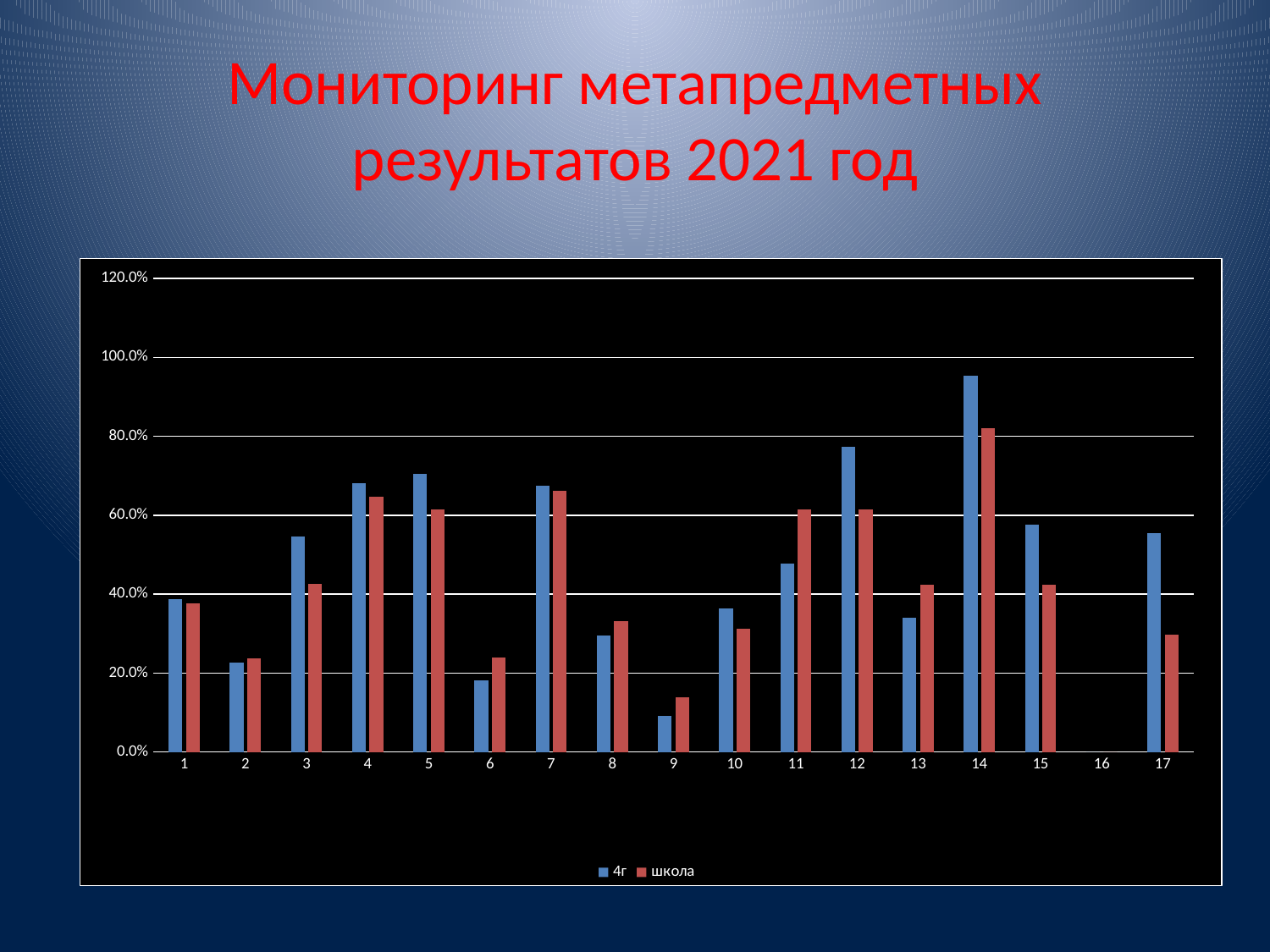
For category 11, which series has the larger value, 4г or школа? школа Is the 4г value for category 14 greater or less than 80.0%? greater For category 15, which series has the larger value, 4г or школа? 4г What kind of chart is shown on the slide? bar chart Which category has the highest value for the школа series? 14 How many categories are labelled on the x axis? 17 How many series does the legend list? 2 Is the 4г value for category 9 greater or less than 20.0%? less Among the categories with bars, which has the lowest value for the 4г series? 9 Is the школа value for category 17 greater or less than 40.0%? less What are the two series named in the legend? 4г and школа Which category has the highest value for the 4г series? 14